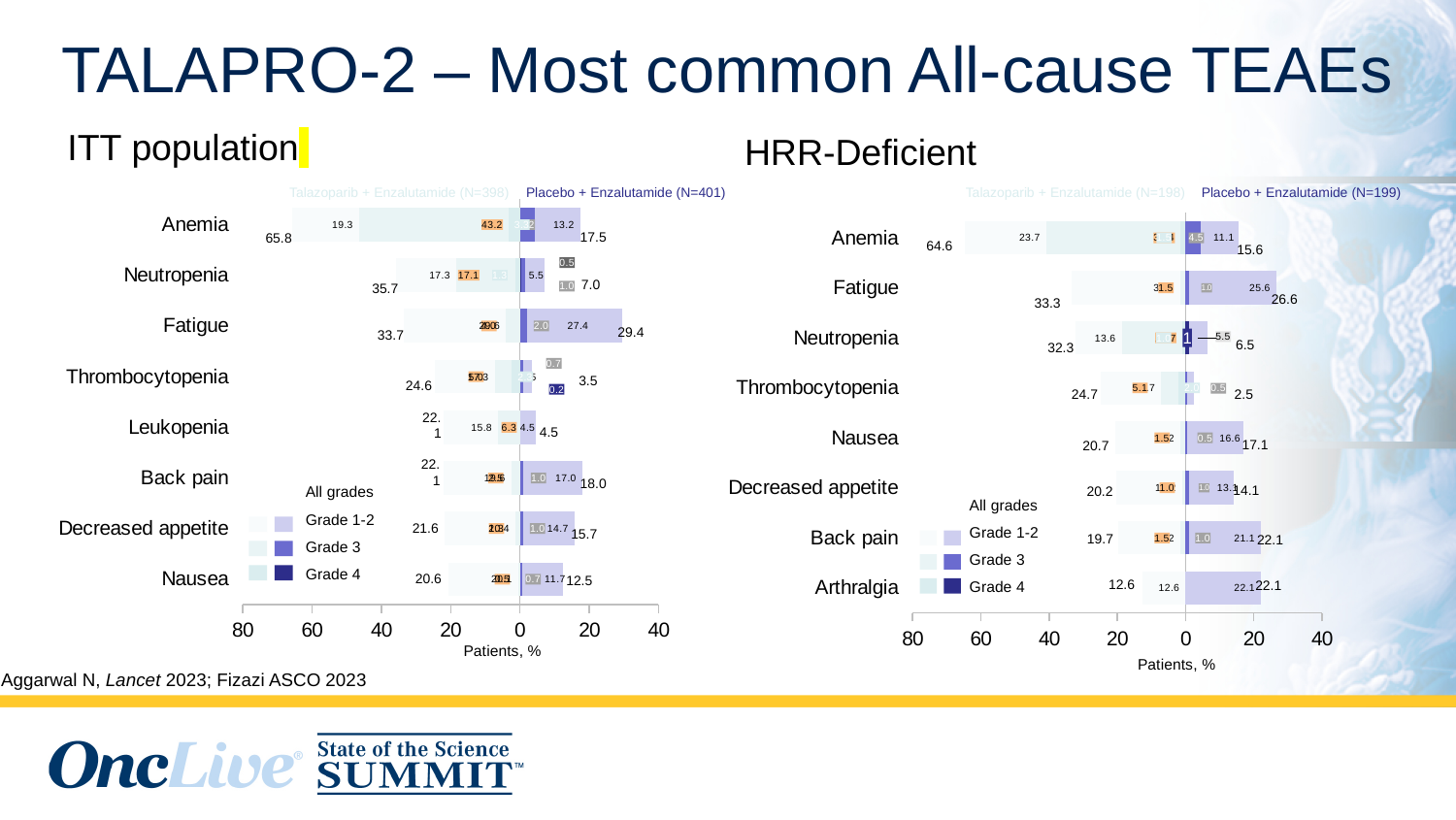
In the HRR-Deficient chart, what is the difference in all-grades anemia percentage between the Talazoparib + Enzalutamide arm (64.6) and the Placebo + Enzalutamide arm (15.6)? 49.0 How many adverse event categories are listed in the ITT population chart? 8 In the ITT population chart, which adverse event has the highest all-grades percentage in the Talazoparib + Enzalutamide arm? Anemia What is the label on the x axis of the ITT population chart? Patients, % In the HRR-Deficient chart, which adverse event has the lowest all-grades percentage in the Talazoparib + Enzalutamide arm? Arthralgia In the ITT population chart, what is the all-grades percentage of patients with fatigue in the Placebo + Enzalutamide arm? 29.4 In the ITT population chart, what is the all-grades percentage of patients with anemia in the Talazoparib + Enzalutamide arm? 65.8 In the HRR-Deficient chart, what is the all-grades percentage of patients with anemia in the Talazoparib + Enzalutamide arm? 64.6 In the HRR-Deficient chart, what is the all-grades percentage of patients with back pain in the Placebo + Enzalutamide arm? 22.1 In the ITT population chart, which arm has the higher all-grades percentage of fatigue, Talazoparib + Enzalutamide or Placebo + Enzalutamide? Talazoparib + Enzalutamide How many entries does the legend of the ITT population chart list? 4 What kind of chart is used for the HRR-Deficient population? Bar chart